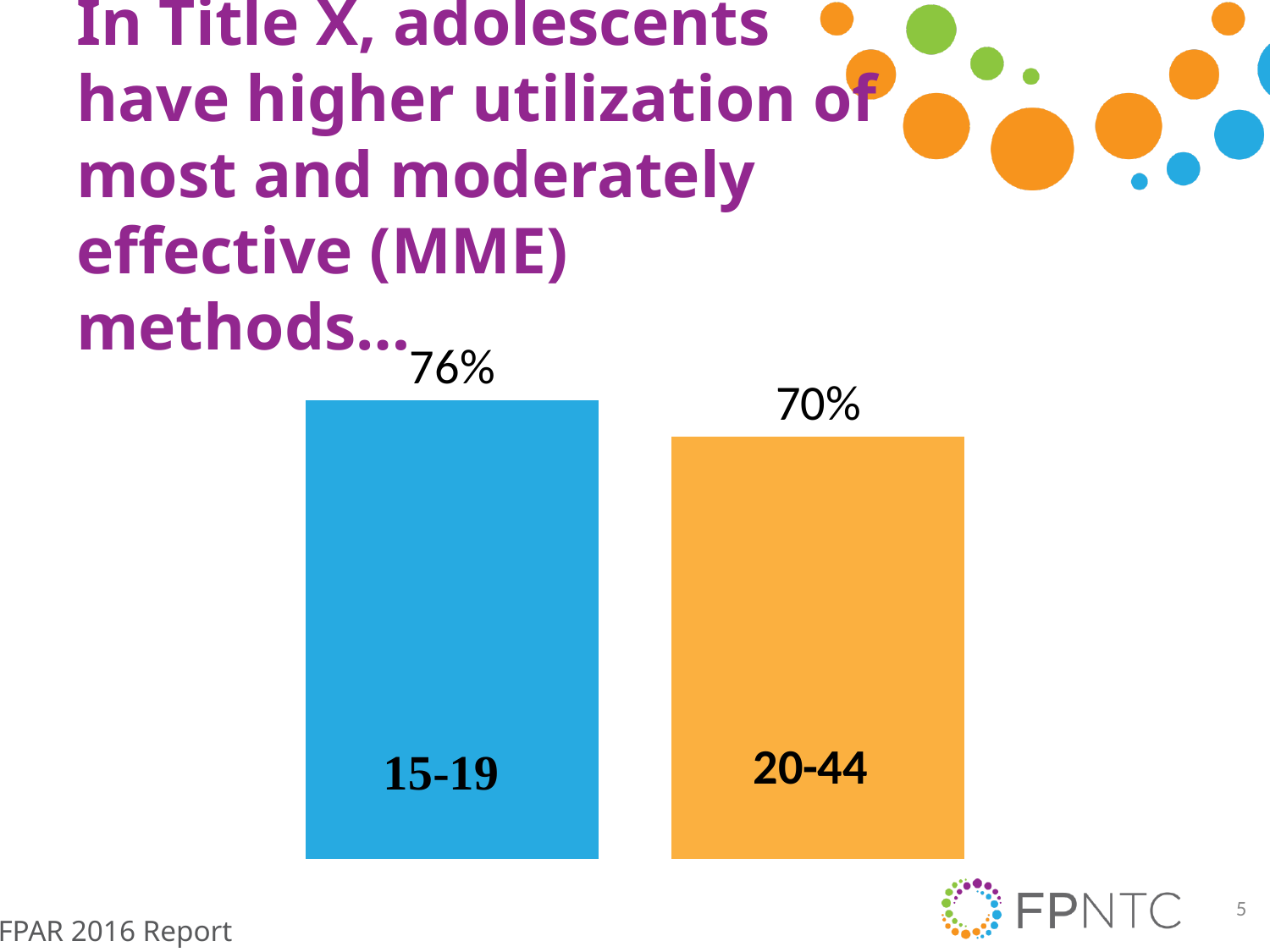
What kind of chart is shown on the slide? Bar chart What is the difference between the values for 15-19 and 20-44? 6% Which is larger, the value for 15-19 or the value for 20-44? 15-19 Which age group has the highest value? 15-19 What colour is the bar for the 15-19 age group? Blue How many age groups are shown in the chart? 2 Which age group has the lowest value? 20-44 What colour is the bar for the 20-44 age group? Orange What is the value for the 15-19 age group? 76% What is the value for the 20-44 age group? 70%